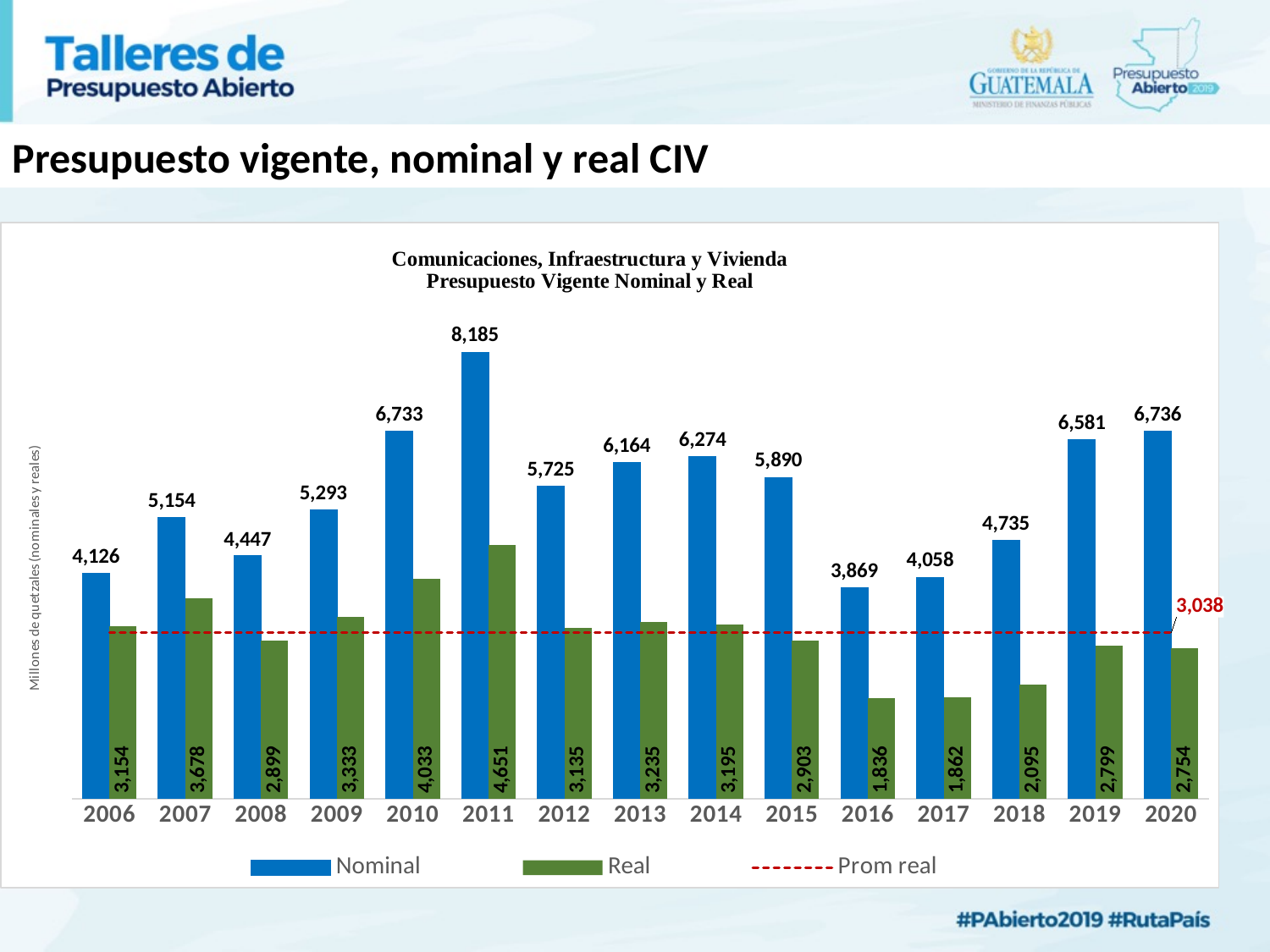
What is the title of the chart? Comunicaciones, Infraestructura y Vivienda Presupuesto Vigente Nominal y Real How many series does the legend list? 3 What is the Real value for 2016? 1,836 Which year has the highest Nominal value? 2011 What is the Real value for 2010? 4,033 Which year has the lowest Real value? 2016 Which is larger, the Real value for 2007 or the Real value for 2009? 2007 What is the Nominal value for 2011? 8,185 What is the difference between the Nominal values for 2020 and 2019? 155 How many years are shown on the x axis? 15 What kind of chart is this? bar chart What is the value of the Prom real line? 3,038